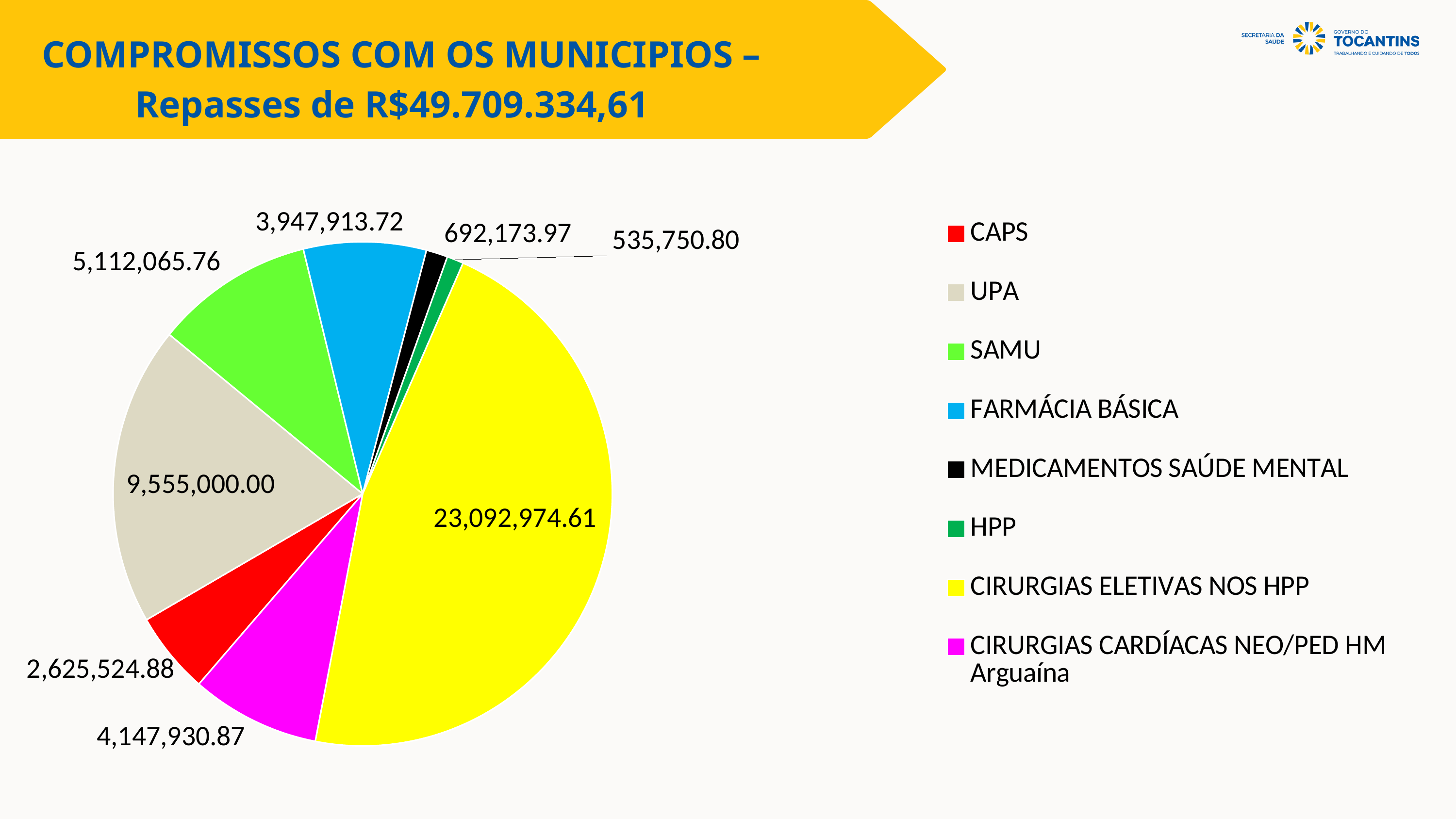
What is the value of the HPP slice? 535,750.80 What is the value of the CIRURGIAS ELETIVAS NOS HPP slice? 23,092,974.61 What is the value of the SAMU slice? 5,112,065.76 Which category has the smallest slice of the pie? HPP What is the value of the MEDICAMENTOS SAÚDE MENTAL slice? 692,173.97 What is the difference between the UPA value and the CAPS value? 6,929,475.12 Which category has the largest slice of the pie? CIRURGIAS ELETIVAS NOS HPP Which is larger, the SAMU slice or the FARMÁCIA BÁSICA slice? SAMU How many slices does the pie chart have? 8 What is the value of the UPA slice? 9,555,000.00 What colour is the CIRURGIAS CARDÍACAS NEO/PED HM Arguaína slice? magenta What type of chart is shown on the slide? pie chart